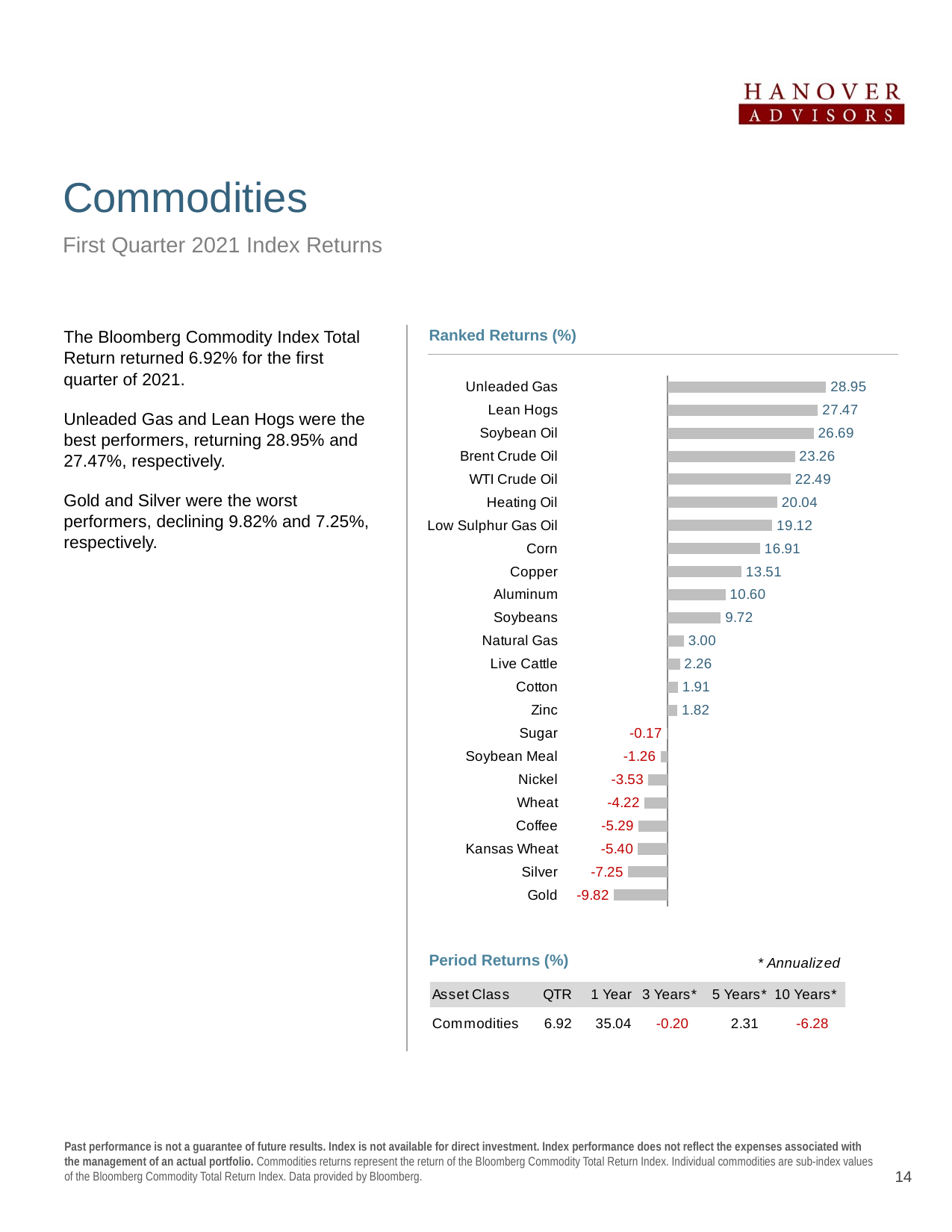
Which commodity has the highest value in the Ranked Returns (%) chart? Unleaded Gas What is the difference between the values for Unleaded Gas and Lean Hogs in the Ranked Returns (%) chart? 1.48 What is the value for Brent Crude Oil in the Ranked Returns (%) chart? 23.26 What is the difference between the values for Corn and Aluminum in the Ranked Returns (%) chart? 6.31 How many commodities are shown in the Ranked Returns (%) chart? 23 What kind of chart is the Ranked Returns (%) chart? Bar chart Which commodity has the lowest value in the Ranked Returns (%) chart? Gold How many commodities in the Ranked Returns (%) chart have negative values? 8 What is the value for Copper in the Ranked Returns (%) chart? 13.51 In the Ranked Returns (%) chart, which is larger, the value for Heating Oil or the value for Low Sulphur Gas Oil? Heating Oil What is the value for Nickel in the Ranked Returns (%) chart? -3.53 In the Ranked Returns (%) chart, which is larger, the value for Silver or the value for Gold? Silver